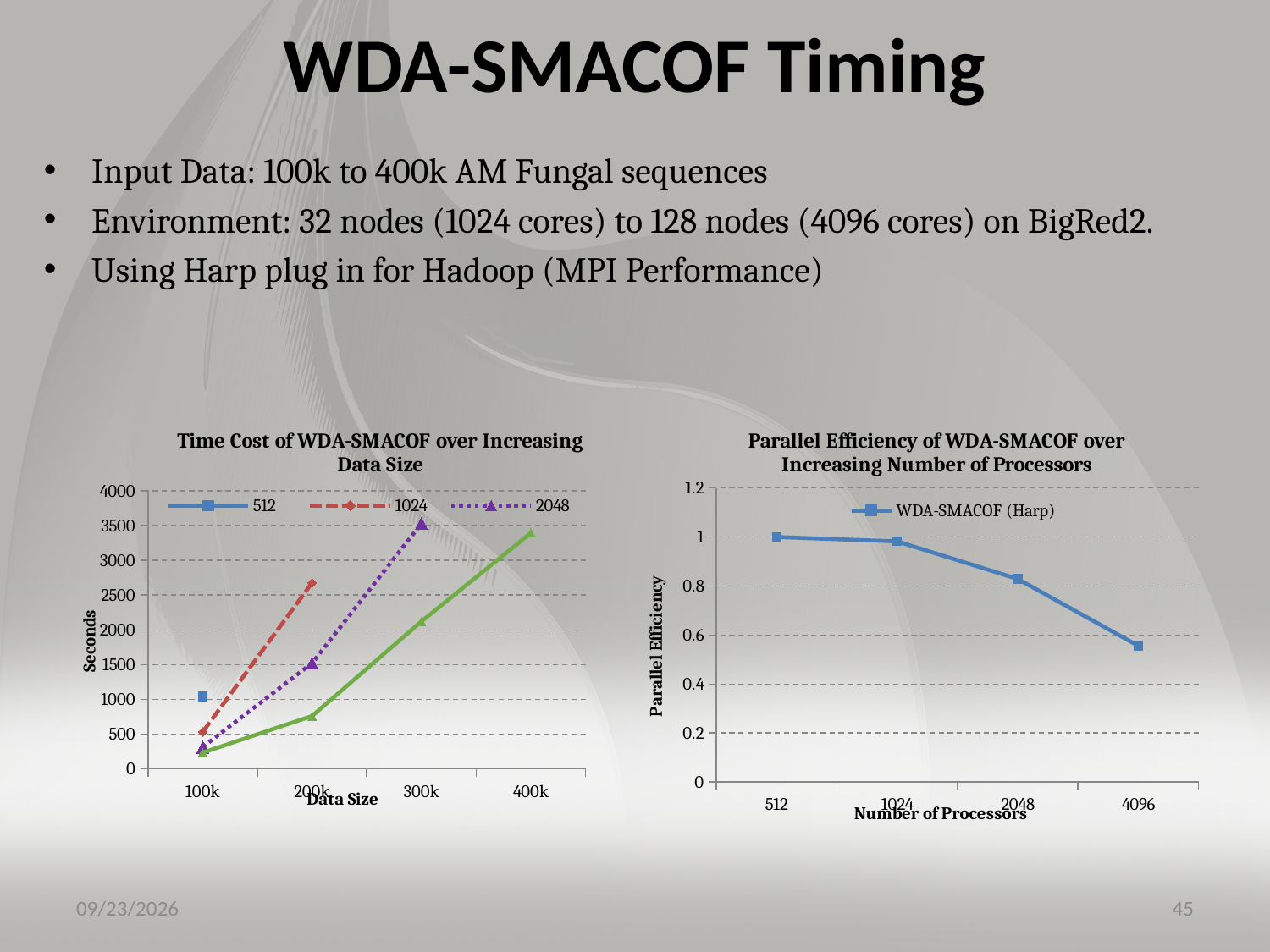
How many data size categories are shown on the x axis of the 'Time Cost of WDA-SMACOF over Increasing Data Size' chart? 4 In the 'Parallel Efficiency of WDA-SMACOF over Increasing Number of Processors' chart, which number of processors has the lowest parallel efficiency? 4096 In the 'Time Cost of WDA-SMACOF over Increasing Data Size' chart, is the value of the 2048 series at 300k greater or less than 3000? greater How many processor counts are plotted on the x axis of the 'Parallel Efficiency of WDA-SMACOF over Increasing Number of Processors' chart? 4 In the 'Parallel Efficiency of WDA-SMACOF over Increasing Number of Processors' chart, do the values rise or fall as the number of processors increases? fall What is the y-axis label of the 'Time Cost of WDA-SMACOF over Increasing Data Size' chart? Seconds In the 'Time Cost of WDA-SMACOF over Increasing Data Size' chart, at 100k, which series has the larger value: 512 or 1024? 512 What kind of chart is the 'Parallel Efficiency of WDA-SMACOF over Increasing Number of Processors' chart? line chart In the 'Parallel Efficiency of WDA-SMACOF over Increasing Number of Processors' chart, is the value at 4096 processors greater or less than 0.6? less How many series does the legend of the 'Time Cost of WDA-SMACOF over Increasing Data Size' chart list? 3 What kind of chart is the 'Time Cost of WDA-SMACOF over Increasing Data Size' chart? line chart In the 'Time Cost of WDA-SMACOF over Increasing Data Size' chart, is the value of the 1024 series at 200k greater or less than 2500? greater